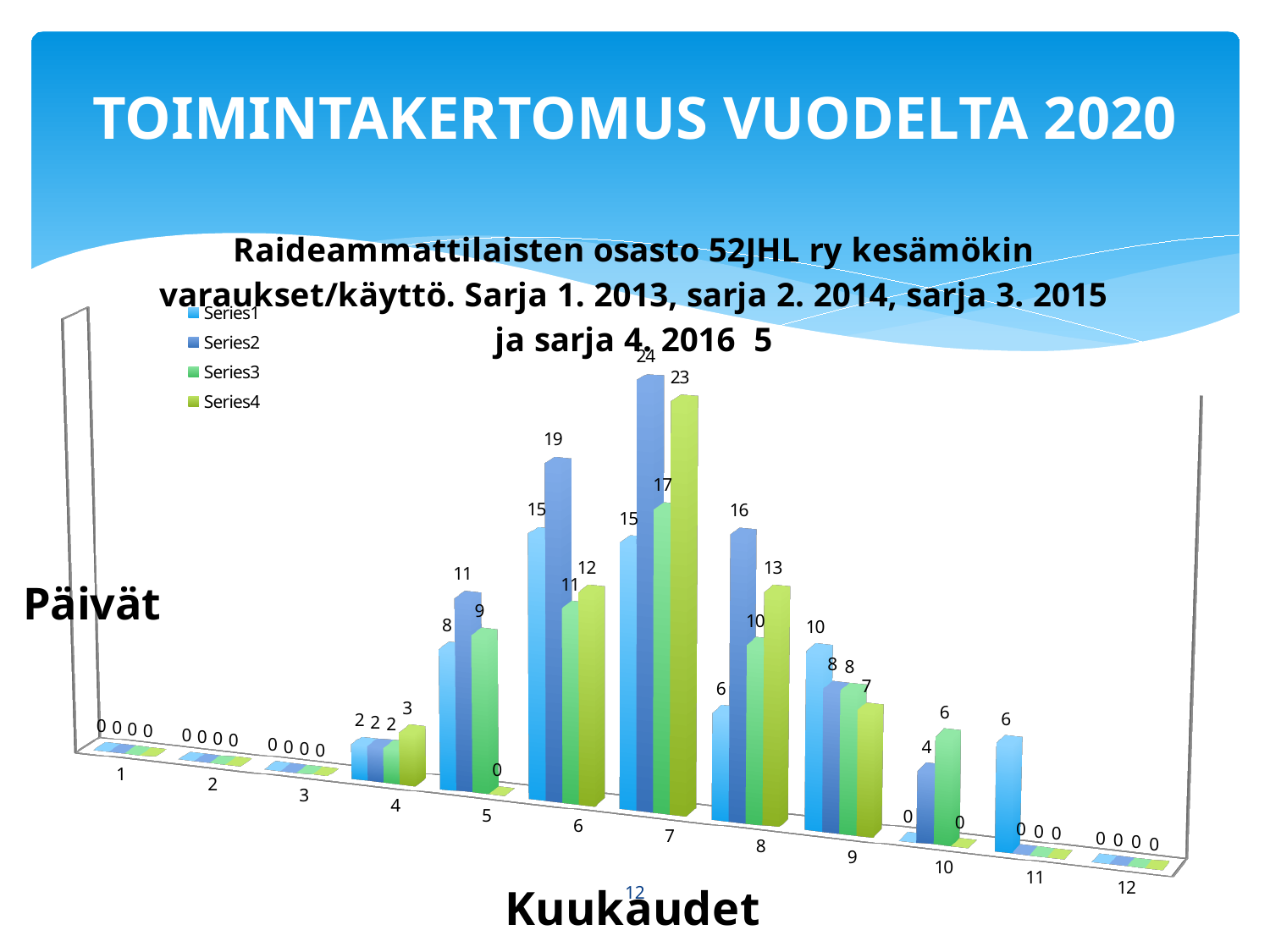
What is the value of Series2 for month 7? 24 What kind of chart is shown on the slide? Bar chart Which month has the highest value for Series2? 7 What is the title of the x axis? Kuukaudet What is the difference between the Series2 and Series1 values for month 7? 9 What is the value of Series4 for month 7? 23 How many series does the legend list? 4 What is the title of the y axis? Päivät What is the value of Series3 for month 10? 6 What is the value of Series1 for month 6? 15 How many months (categories) are shown on the x axis? 12 For month 8, which is larger: Series2 or Series3? Series2